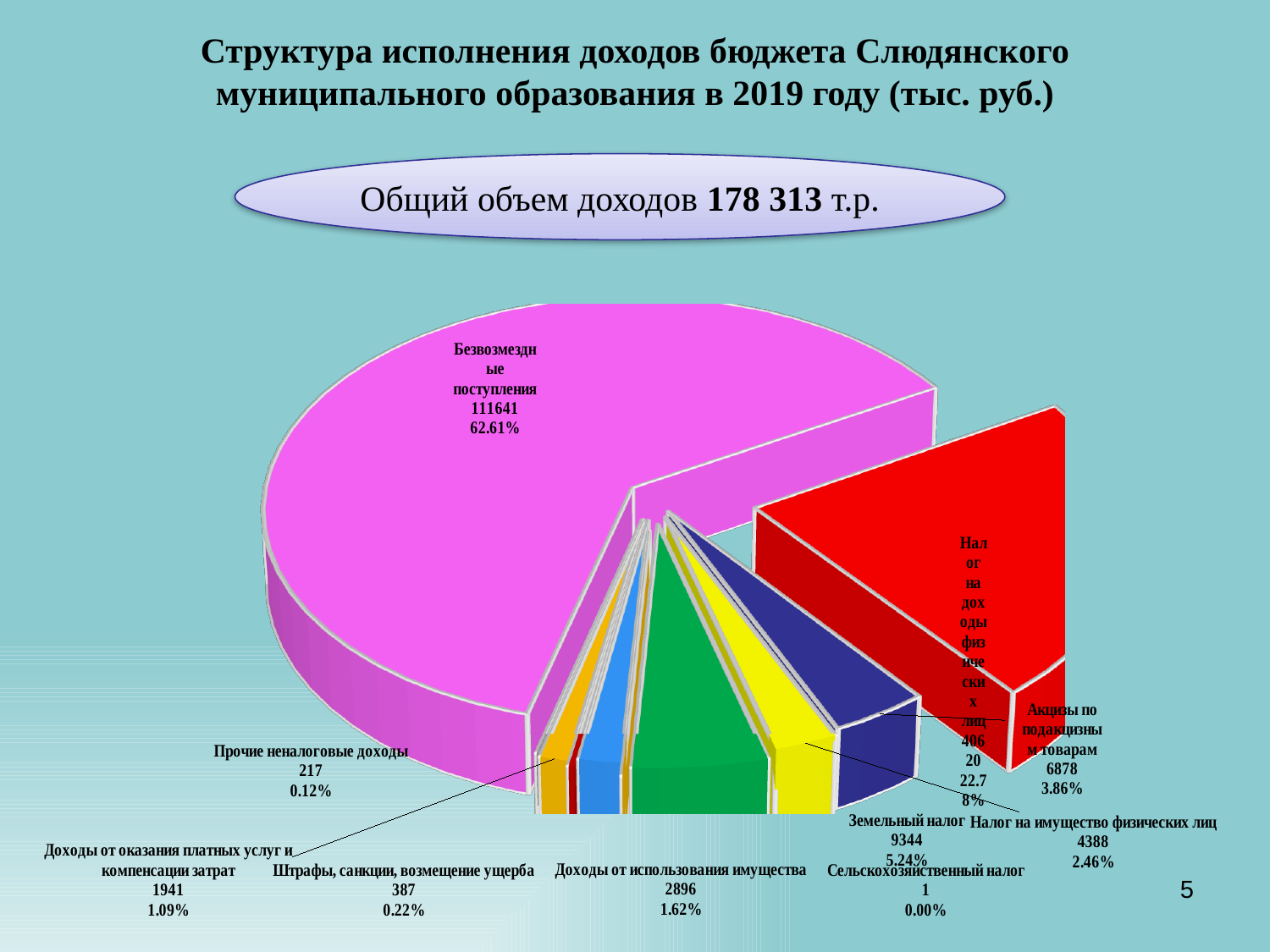
Which category has the smallest value? Сельскохозяйственный налог What total revenue amount is stated on the slide? 178 313 т.р. How many categories are shown in the pie chart? 10 What is the difference between Земельный налог and Налог на имущество физических лиц? 4956 What is the value for Налог на имущество физических лиц? 4388 What share of the pie does Безвозмездные поступления take? 62.61% What is the value for Земельный налог? 9344 What kind of chart is shown on the slide? pie chart Which category has the largest slice of the pie? Безвозмездные поступления What percentage is shown for Акцизы по подакцизным товарам? 3.86% Which is larger: Доходы от использования имущества or Доходы от оказания платных услуг и компенсации затрат? Доходы от использования имущества What is the value for Безвозмездные поступления? 111641